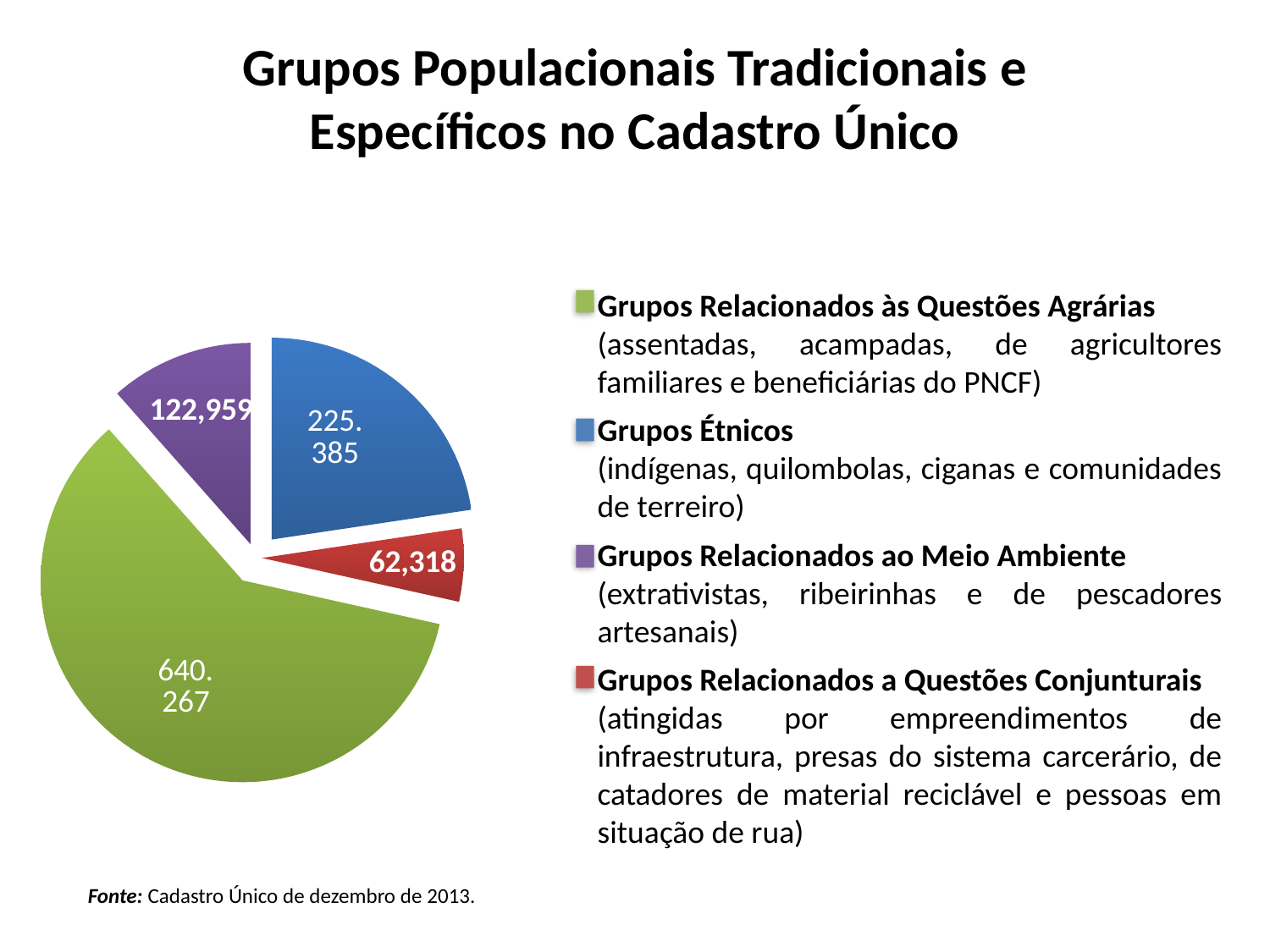
What value is shown for Grupos Relacionados ao Meio Ambiente? 122,959 Which group has the smallest slice of the pie? Grupos Relacionados a Questões Conjunturais What colour is the slice for Grupos Étnicos? blue Which group has the largest slice of the pie? Grupos Relacionados às Questões Agrárias How many slices does the pie chart have? 4 Which is larger, the value for Grupos Étnicos or the value for Grupos Relacionados ao Meio Ambiente? Grupos Étnicos What kind of chart is shown on the slide? pie chart What value is shown for Grupos Relacionados às Questões Agrárias? 640.267 What source is cited for the chart data? Cadastro Único de dezembro de 2013 What is the difference between the value for Grupos Relacionados ao Meio Ambiente and the value for Grupos Relacionados a Questões Conjunturais? 60,641 What value is shown for Grupos Relacionados a Questões Conjunturais? 62,318 What value is shown for Grupos Étnicos? 225.385